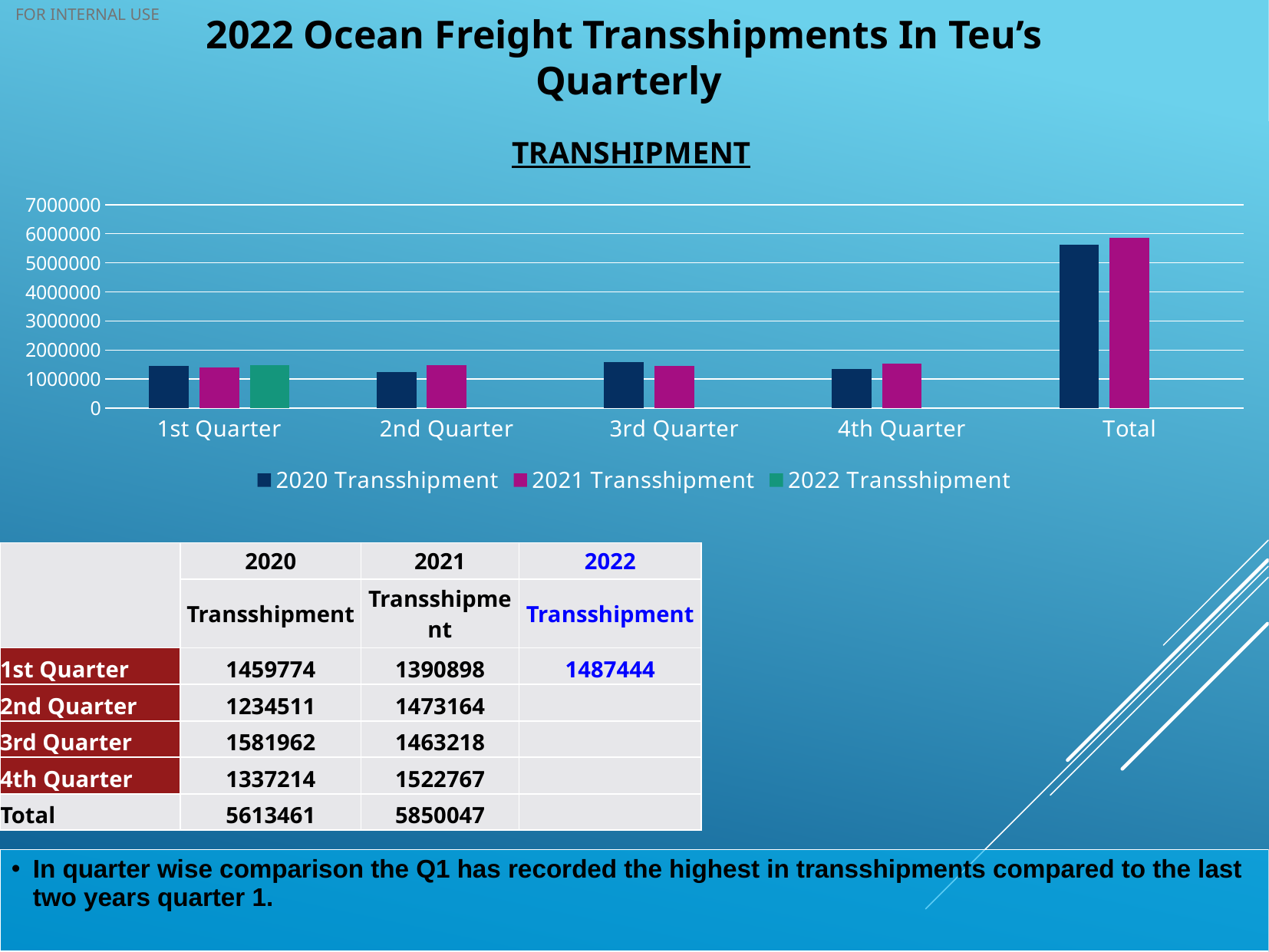
What kind of chart is shown on the slide? bar chart Is the 2020 Transshipment value for Total greater or less than 5000000? greater What colour represents the 2021 Transshipment series in the chart? magenta Among the four quarters, which quarter has the lowest 2020 Transshipment bar? 2nd Quarter What is the 2022 Transshipment value for 1st Quarter? 1487444 Among the four quarters, which quarter has the highest 2020 Transshipment bar? 3rd Quarter What is the title of the chart? TRANSHIPMENT How many series does the chart legend list? 3 Is the 2021 Transshipment value for 2nd Quarter greater or less than 2000000? less For the Total category, which is larger: 2020 Transshipment or 2021 Transshipment? 2021 Transshipment What is the difference between the 2021 Transshipment Total and the 2020 Transshipment Total? 236586 How many categories are shown on the x axis of the chart? 5